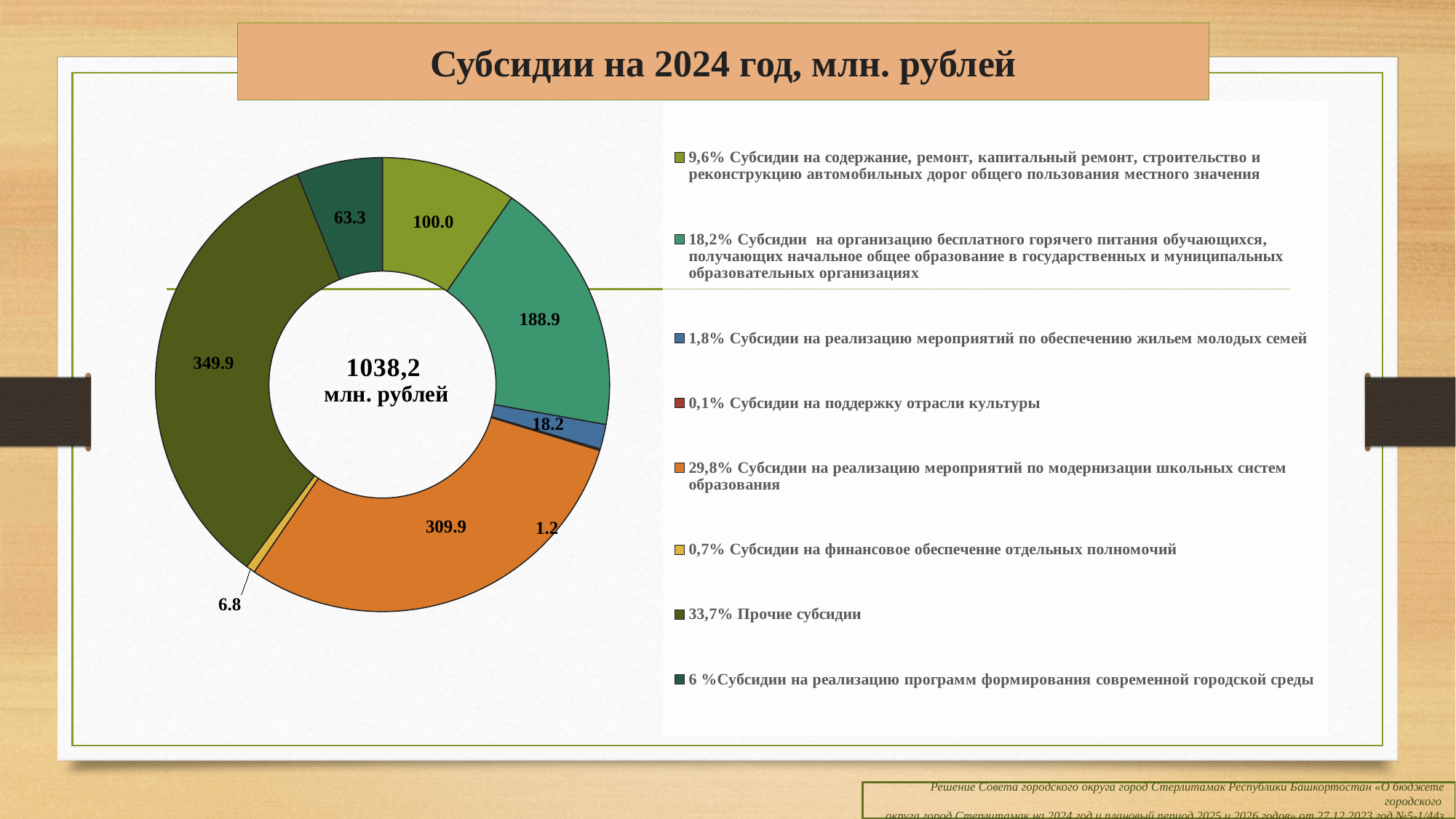
What kind of chart is shown on the slide? Doughnut (pie) chart What is the value for Субсидии на организацию бесплатного горячего питания обучающихся? 188.9 What total is shown in the centre of the chart? 1038,2 млн. рублей What is the value for Субсидии на поддержку отрасли культуры? 1.2 What is the title of the chart? Субсидии на 2024 год, млн. рублей What is the value for Прочие субсидии? 349.9 Which is larger: the value for Субсидии на содержание, ремонт, капитальный ремонт, строительство и реконструкцию автомобильных дорог or the value for Субсидии на реализацию программ формирования современной городской среды? Субсидии на содержание, ремонт, капитальный ремонт, строительство и реконструкцию автомобильных дорог Which category has the smallest value? Субсидии на поддержку отрасли культуры What is the difference between the values for Прочие субсидии and Субсидии на реализацию мероприятий по модернизации школьных систем образования? 40.0 Which category has the largest value? Прочие субсидии What share of the total do Субсидии на реализацию мероприятий по модернизации школьных систем образования represent? 29,8% How many categories does the chart show? 8